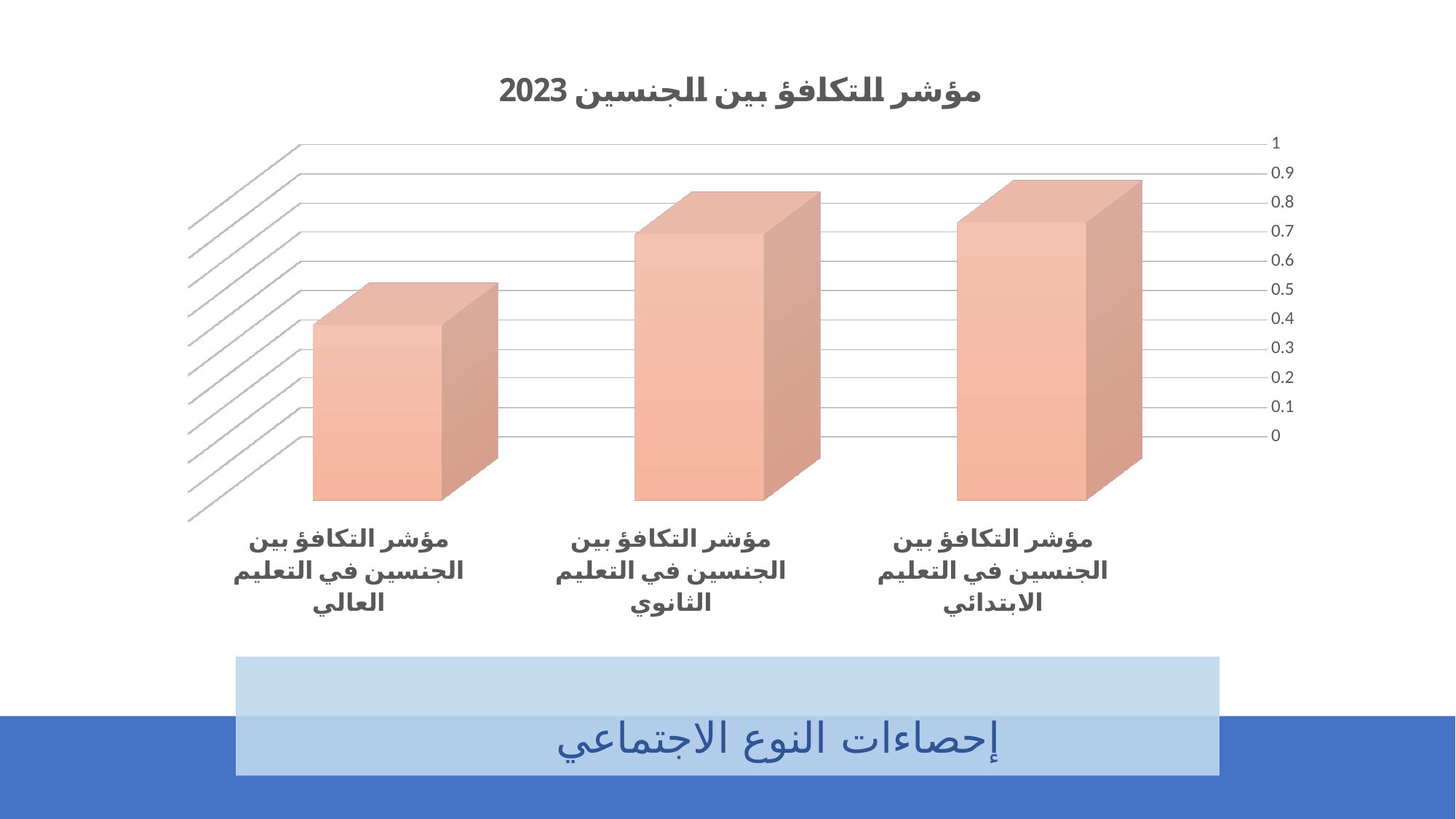
Is the value for مؤشر التكافؤ بين الجنسين في التعليم العالي greater or less than 0.3? greater Which is larger: the value for مؤشر التكافؤ بين الجنسين في التعليم الثانوي or the value for مؤشر التكافؤ بين الجنسين في التعليم العالي? مؤشر التكافؤ بين الجنسين في التعليم الثانوي Which category has the highest value? مؤشر التكافؤ بين الجنسين في التعليم الابتدائي How many categories (bars) does the chart show? 3 Is the value for مؤشر التكافؤ بين الجنسين في التعليم الابتدائي greater or less than 0.7? greater Which category has the lowest value? مؤشر التكافؤ بين الجنسين في التعليم العالي What is the maximum value shown on the vertical axis? 1 Is the value for مؤشر التكافؤ بين الجنسين في التعليم العالي greater or less than 0.8? less What is the title of the chart? مؤشر التكافؤ بين الجنسين 2023 What kind of chart is shown on the slide? bar chart